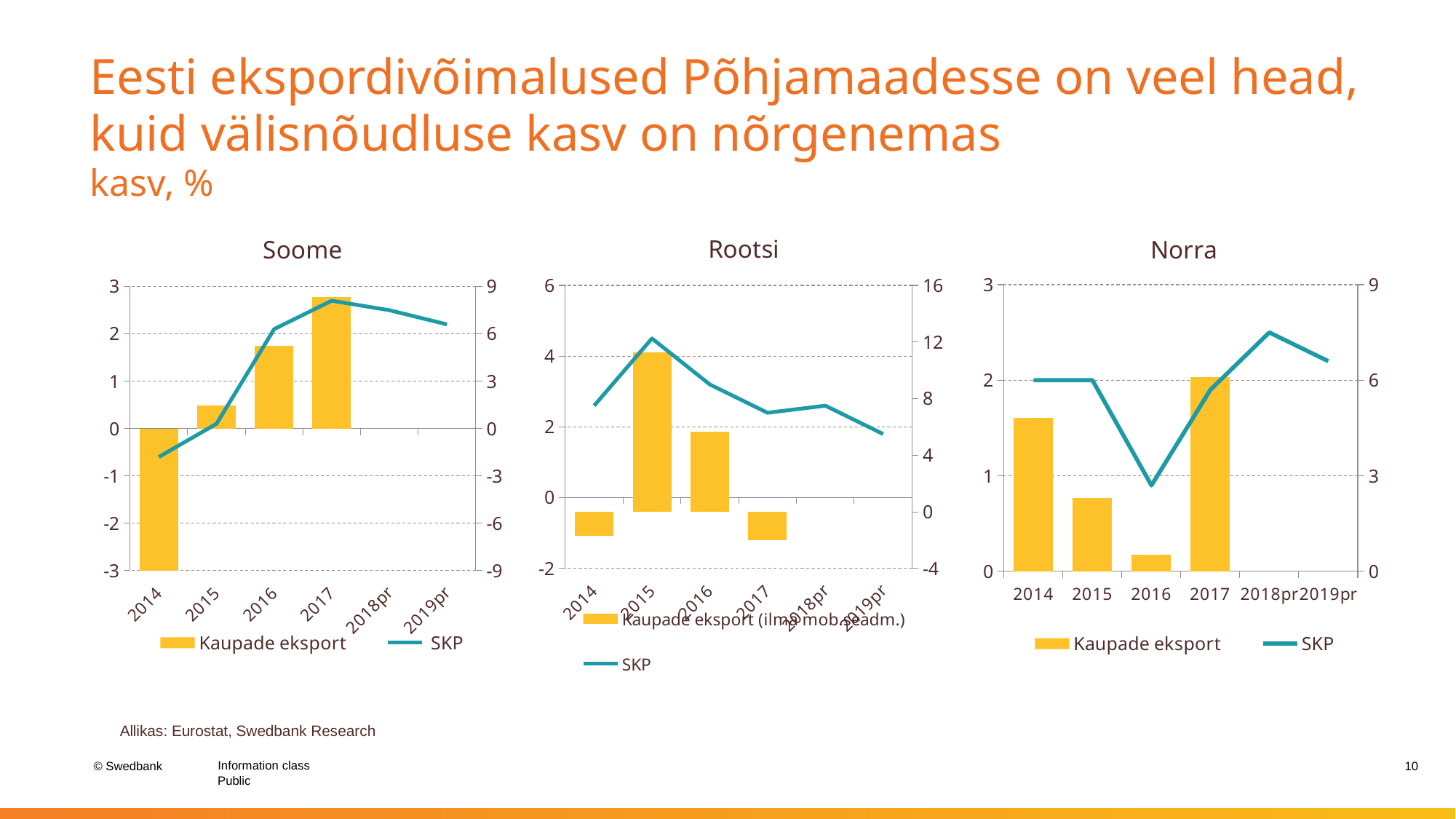
In the Norra chart, which year has the highest Kaupade eksport bar? 2017 In the Soome chart, does the SKP line rise or fall from 2014 to 2017? rise In the Soome chart, is the Kaupade eksport value for 2016 greater or less than 1? greater In the Soome chart, which year has the highest Kaupade eksport bar? 2017 In the Rootsi chart, which year has the highest Kaupade eksport bar? 2015 What kind of chart is the Rootsi chart? Combined bar and line chart In the Soome chart, which year has the lowest Kaupade eksport bar? 2014 How many series does the legend of the Soome chart list? 2 How many years are shown on the x axis of the Norra chart? 6 In the Rootsi chart, is the Kaupade eksport value for 2015 greater or less than 2? greater In the Norra chart, is the Kaupade eksport bar larger for 2014 or for 2015? 2014 In the Norra chart, which year has the lowest Kaupade eksport bar? 2016